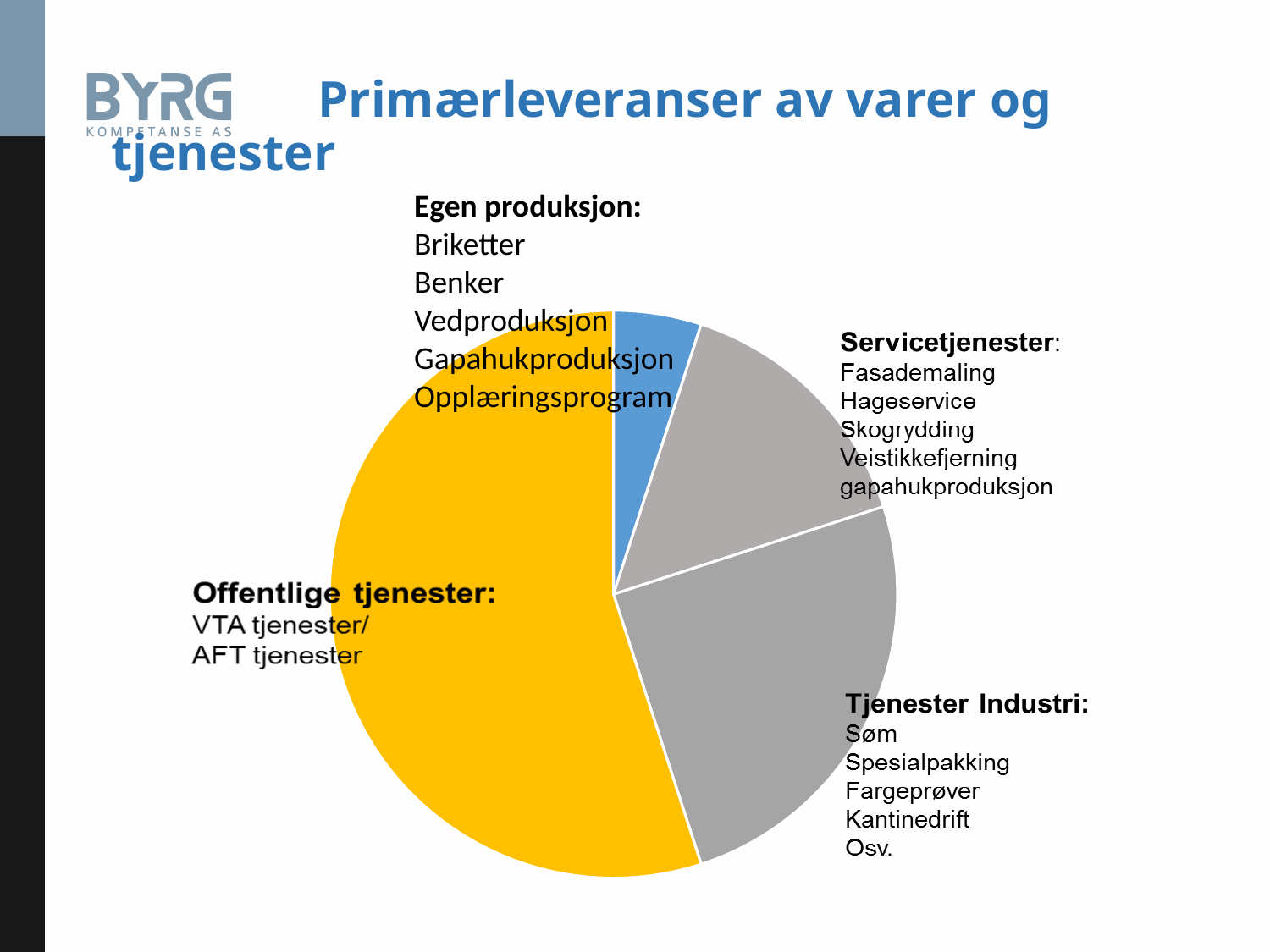
What colour is the Offentlige tjenester slice? Yellow Which category has the smallest slice of the pie chart? Egen produksjon Does the Offentlige tjenester slice take up more or less than half of the pie? More Which category has the largest slice of the pie chart? Offentlige tjenester Which slice is larger: Offentlige tjenester or Servicetjenester? Offentlige tjenester Which slice is larger: Offentlige tjenester or Tjenester Industri? Offentlige tjenester What kind of chart is shown on the slide? Pie chart How many slices does the pie chart have? 4 Which slice is larger: Servicetjenester or Egen produksjon? Servicetjenester Which category is shown in blue on the pie chart? Egen produksjon